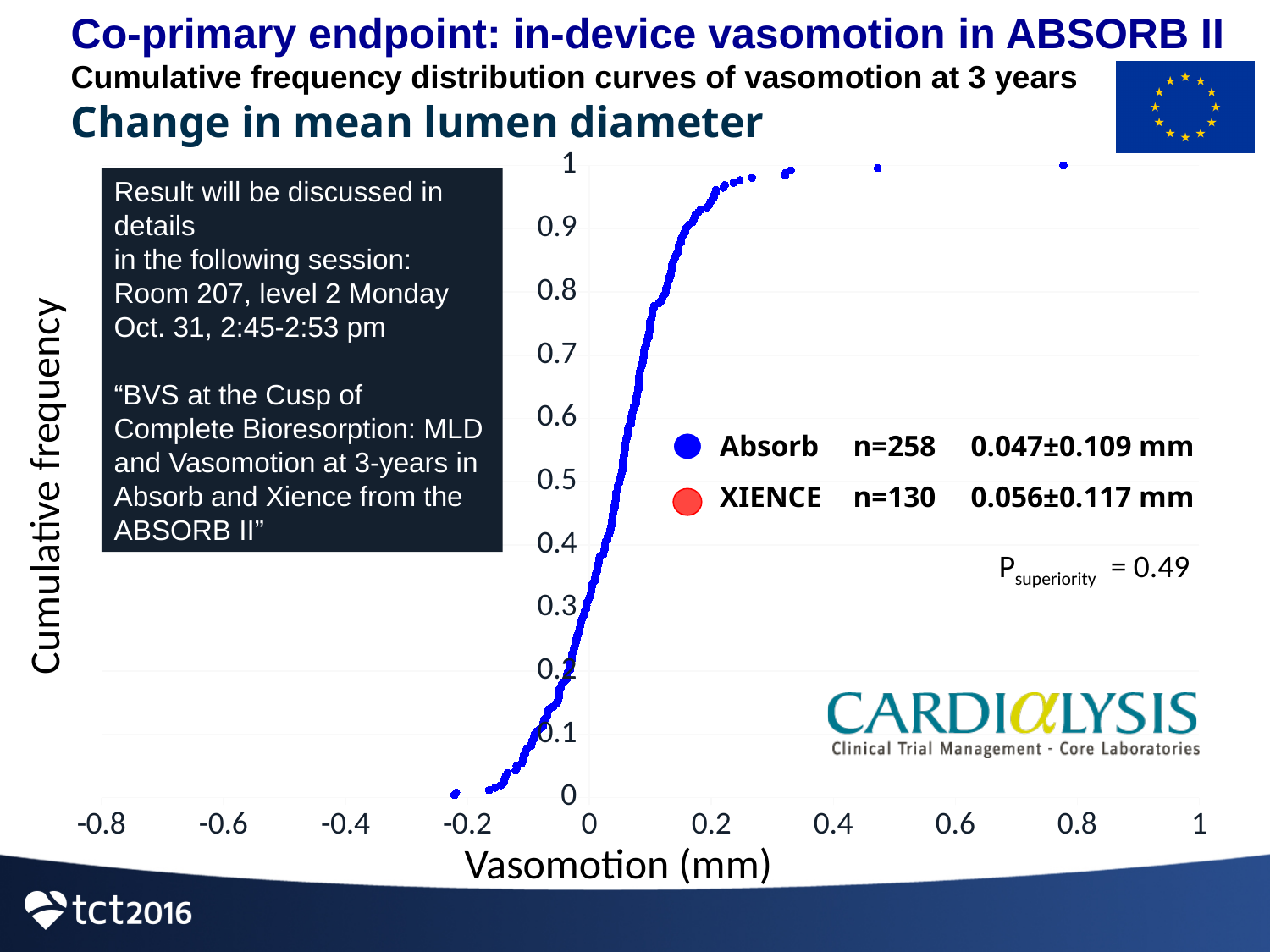
What kind of chart is shown on the slide? Scatter plot (cumulative frequency distribution curve) What is the sample size (n) shown for the Absorb series? n=258 What is the P value for superiority shown on the chart? 0.49 Which series has the larger mean vasomotion value, Absorb or XIENCE? XIENCE What mean vasomotion value is shown for XIENCE in the legend? 0.056±0.117 mm What is the label of the x axis? Vasomotion (mm) What are the two series named in the chart legend? Absorb and XIENCE At a vasomotion of 0.2 mm, is the cumulative frequency of the Absorb curve greater or less than 0.9? greater What mean vasomotion value is shown for Absorb in the legend? 0.047±0.109 mm How many series does the chart legend list? 2 Does the plotted cumulative frequency curve rise or fall as vasomotion increases along the x axis? Rise What is the sample size (n) shown for the XIENCE series? n=130